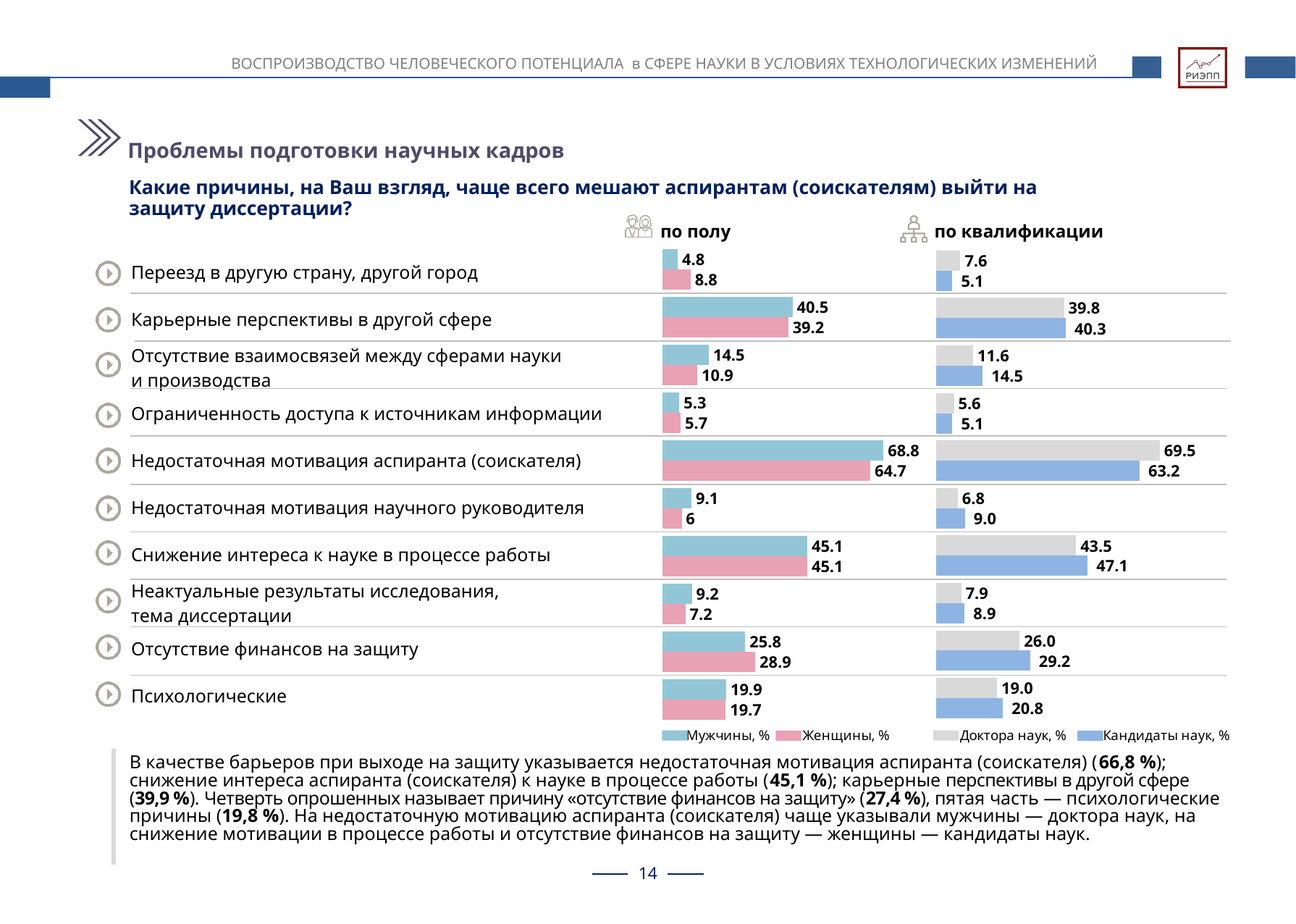
How many categories (reasons) are shown in the 'по полу' chart? 10 In the 'по полу' chart, what is the difference between Мужчины and Женщины for 'Переезд в другую страну, другой город'? 4.0 In the 'по квалификации' chart, for 'Отсутствие финансов на защиту', which is larger: Доктора наук or Кандидаты наук? Кандидаты наук In the 'по полу' chart, which category has the lowest value for Мужчины? Переезд в другую страну, другой город What type of chart is the 'по полу' chart? Bar chart In the 'по полу' chart, what is the value for Мужчины for 'Недостаточная мотивация аспиранта (соискателя)'? 68.8 In the 'по полу' chart, for 'Отсутствие взаимосвязей между сферами науки и производства', which is larger: Мужчины or Женщины? Мужчины How many series does the legend of the 'по квалификации' chart list? 2 In the 'по квалификации' chart, what is the difference between Доктора наук and Кандидаты наук for 'Недостаточная мотивация аспиранта (соискателя)'? 6.3 In the 'по квалификации' chart, what is the value for Кандидаты наук for 'Снижение интереса к науке в процессе работы'? 47.1 In the 'по полу' chart, what is the value for Женщины for 'Отсутствие финансов на защиту'? 28.9 In the 'по квалификации' chart, which category has the highest value for Доктора наук? Недостаточная мотивация аспиранта (соискателя)